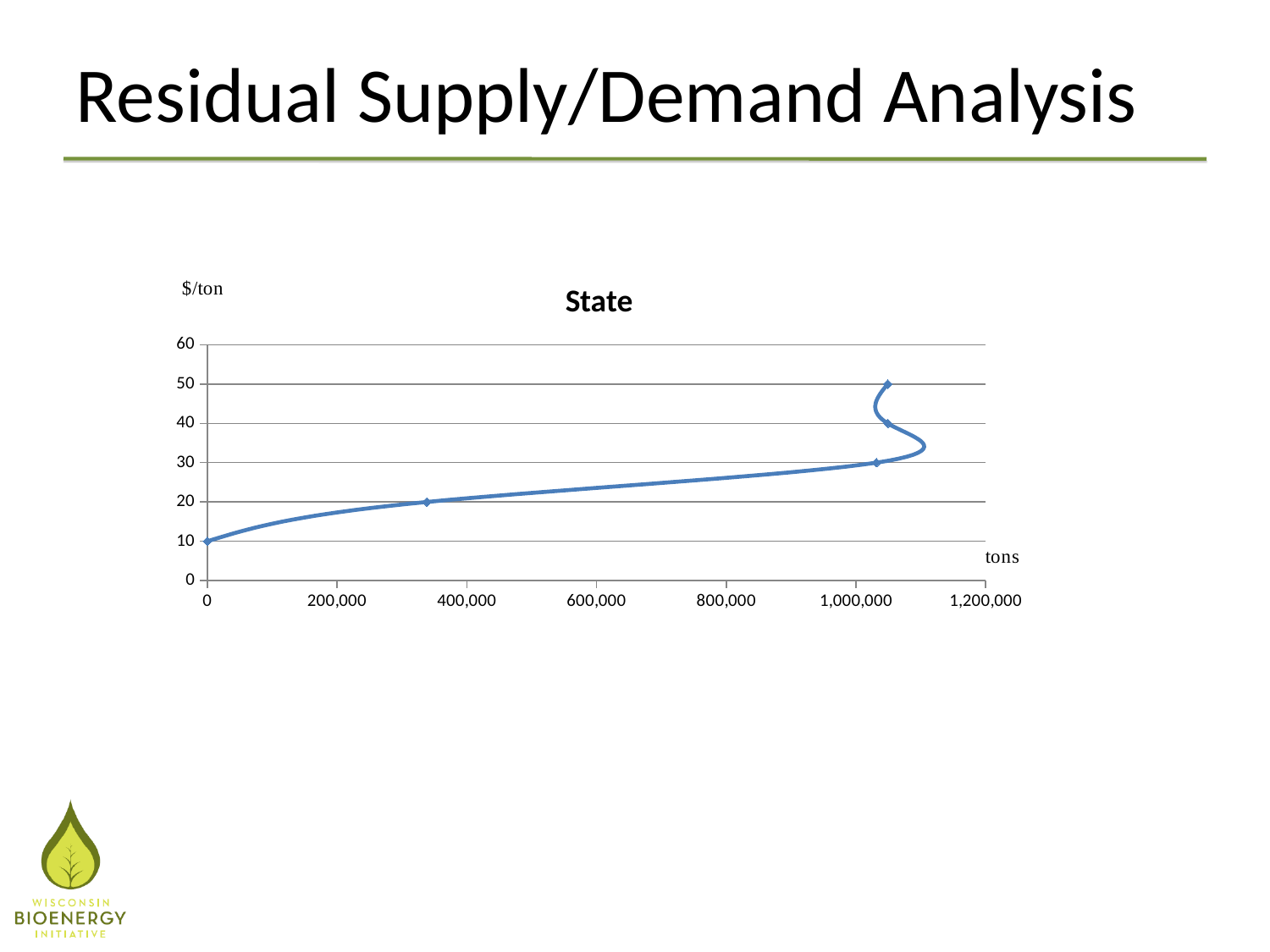
What is the $/ton value of the data point at 0 tons? 10 Is the tons value for the point at 20 $/ton greater or less than 400,000? less Is the tons value for the point at 30 $/ton greater or less than 1,000,000? greater What is the title of the chart? State How many data points are plotted on the chart? 5 Does the $/ton value rise or fall as tons increase from 0 to 1,000,000? rise What unit is shown on the vertical axis of the chart? $/ton What kind of chart is shown on the slide? line chart Which point has a larger tons value: the one at 20 $/ton or the one at 30 $/ton? the one at 30 $/ton Is the tons value for the point at 50 $/ton greater or less than 1,200,000? less What is the highest $/ton value reached by the plotted points? 50 What is the lowest $/ton value among the plotted points? 10